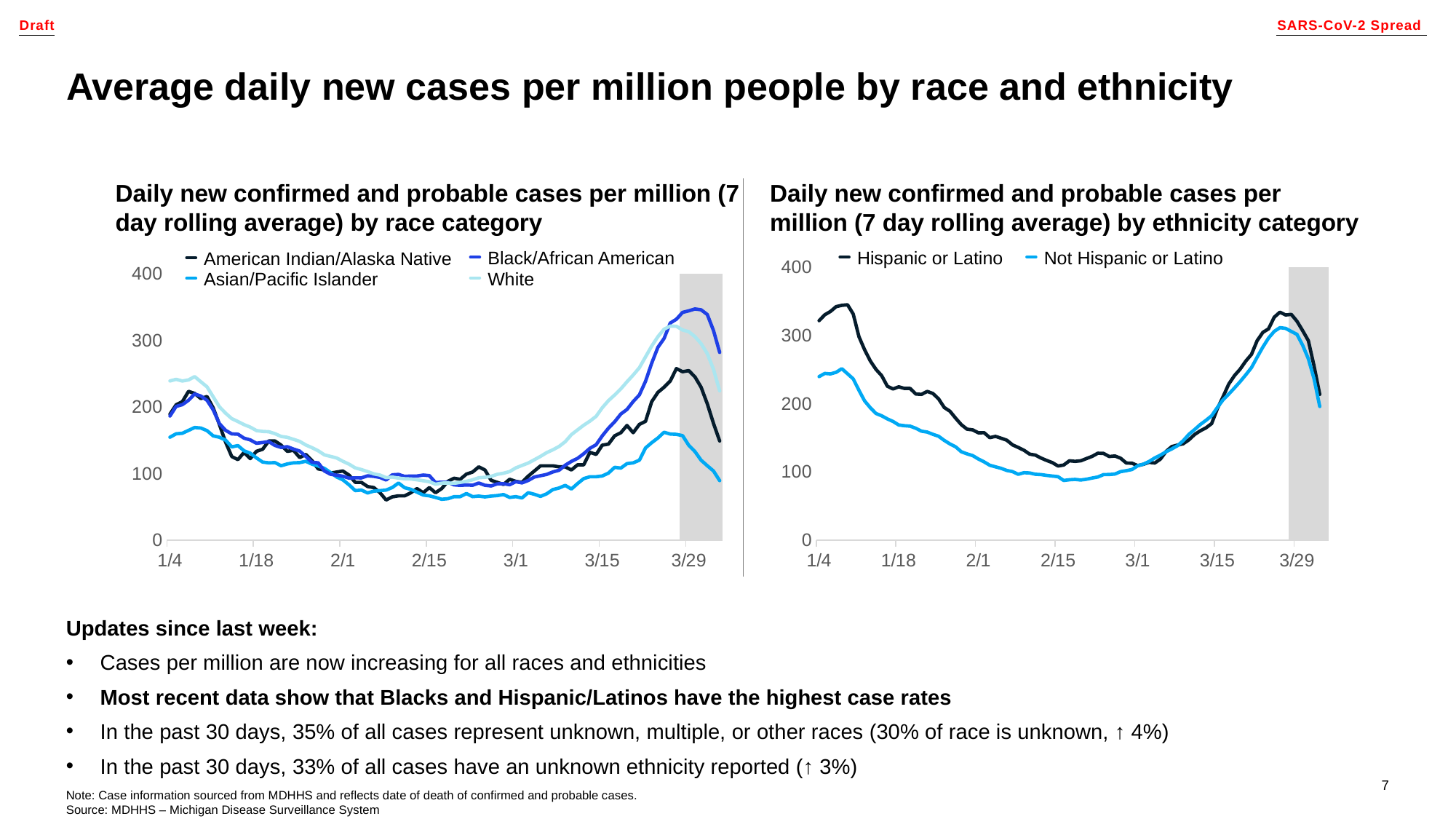
In the right chart (by ethnicity category), do the values for Hispanic or Latino rise or fall between 1/4 and 2/15? fall How many series does the legend of the right chart (by ethnicity category) list? 2 What is the title of the right chart? Daily new confirmed and probable cases per million (7 day rolling average) by ethnicity category In the left chart (by race category), is the peak value for Black/African American around 3/29 greater or less than 300? greater In the left chart (by race category), which series has the lowest value at the end of the period? Asian/Pacific Islander In the right chart (by ethnicity category), which series is higher at its peak near 3/29, Hispanic or Latino or Not Hispanic or Latino? Hispanic or Latino What kind of chart is the left chart, 'Daily new confirmed and probable cases per million (7 day rolling average) by race category'? line chart In the right chart (by ethnicity category), is the value for Not Hispanic or Latino around 2/15 greater or less than 100? less In the right chart (by ethnicity category), is the value for Hispanic or Latino on 1/4 greater or less than 300? greater In the left chart (by race category), which series reaches the highest value around 3/29? Black/African American How many series does the legend of the left chart (by race category) list? 4